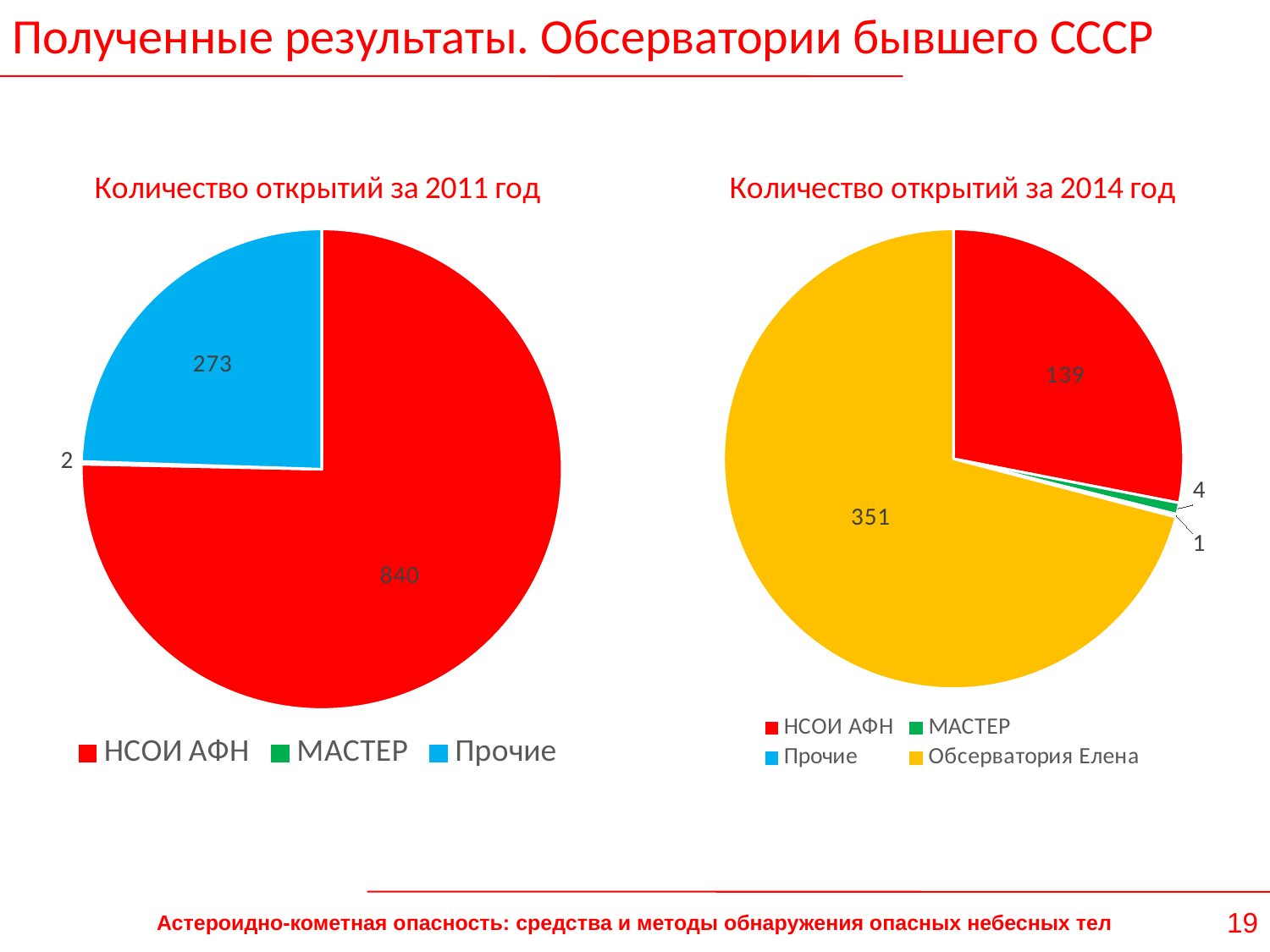
In the chart titled "Количество открытий за 2011 год", what is the value for НСОИ АФН? 840 In the chart titled "Количество открытий за 2014 год", which category has the smallest value? Прочие In the chart titled "Количество открытий за 2011 год", what is the value for МАСТЕР? 2 How many categories does the legend of the chart titled "Количество открытий за 2014 год" list? 4 In the chart titled "Количество открытий за 2014 год", which is larger: the value for МАСТЕР or the value for Прочие? МАСТЕР In the chart titled "Количество открытий за 2014 год", what is the value for НСОИ АФН? 139 In the chart titled "Количество открытий за 2011 год", what is the value for Прочие? 273 In the chart titled "Количество открытий за 2014 год", what is the difference between the values for Обсерватория Елена and НСОИ АФН? 212 In the chart titled "Количество открытий за 2011 год", which category has the largest value? НСОИ АФН What type of chart is the chart titled "Количество открытий за 2011 год"? Pie chart In the chart titled "Количество открытий за 2014 год", what is the value for Обсерватория Елена? 351 In the chart titled "Количество открытий за 2011 год", what is the difference between the values for НСОИ АФН and Прочие? 567